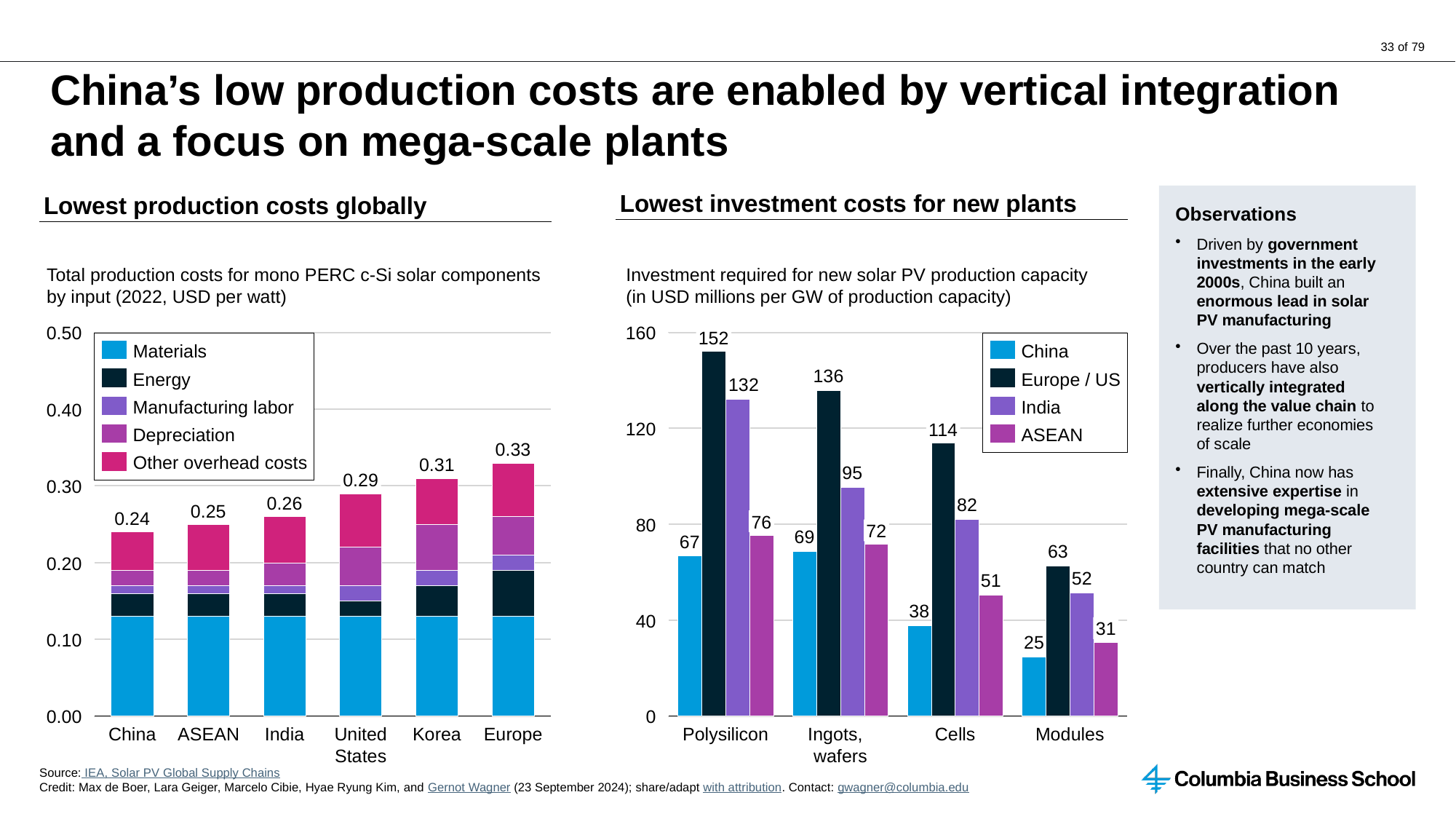
In the 'Lowest investment costs for new plants' chart, what is the difference between the India and ASEAN values for Ingots, wafers? 23 In the 'Lowest production costs globally' chart, what kind of chart is shown? stacked bar chart In the 'Lowest production costs globally' chart, how many series does the legend list? 5 In the 'Lowest production costs globally' chart, which country has the highest total production cost? Europe In the 'Lowest production costs globally' chart, what is the difference between the total for Europe and the total for China? 0.09 In the 'Lowest production costs globally' chart, what is the total production cost for China? 0.24 In the 'Lowest investment costs for new plants' chart, what is the value for China for Modules? 25 In the 'Lowest investment costs for new plants' chart, how many categories are shown on the x axis? 4 In the 'Lowest production costs globally' chart, do the total values rise or fall from China to Europe along the x axis? rise In the 'Lowest investment costs for new plants' chart, which is larger for Modules: India or ASEAN? India In the 'Lowest investment costs for new plants' chart, what is the value for Europe / US for Polysilicon? 152 In the 'Lowest investment costs for new plants' chart, which region has the lowest value for Cells? China